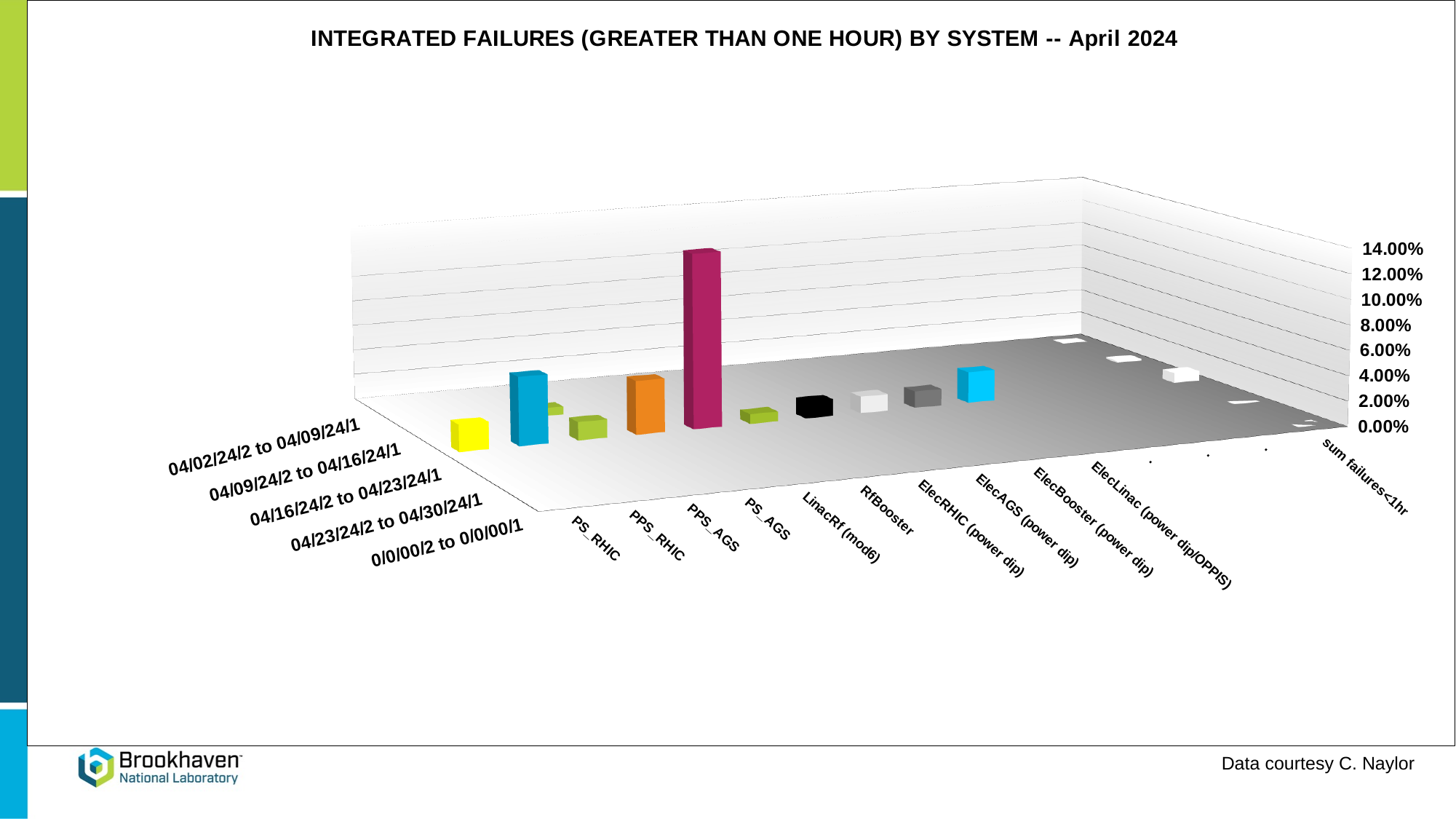
Is the value of the cyan bar for PPS_RHIC greater or less than 8.00%? less What is the highest value shown on the vertical axis? 14.00% What is the label of the last category on the horizontal axis? sum failures<1hr Is the value of the tallest (magenta) bar greater or less than 4.00%? greater How many date-range labels are shown along the depth axis of the chart? 5 What kind of chart is shown on the slide? 3D bar chart Is the value of the yellow bar for PS_RHIC greater or less than 6.00%? less Which bar is taller, the magenta bar or the orange bar for PPS_AGS? The magenta bar What colour is the tallest bar in the chart? Magenta What is the lowest value shown on the vertical axis? 0.00% What is the first date range listed on the depth axis? 04/02/24/2 to 04/09/24/1 What is the title of the chart? INTEGRATED FAILURES (GREATER THAN ONE HOUR) BY SYSTEM -- April 2024